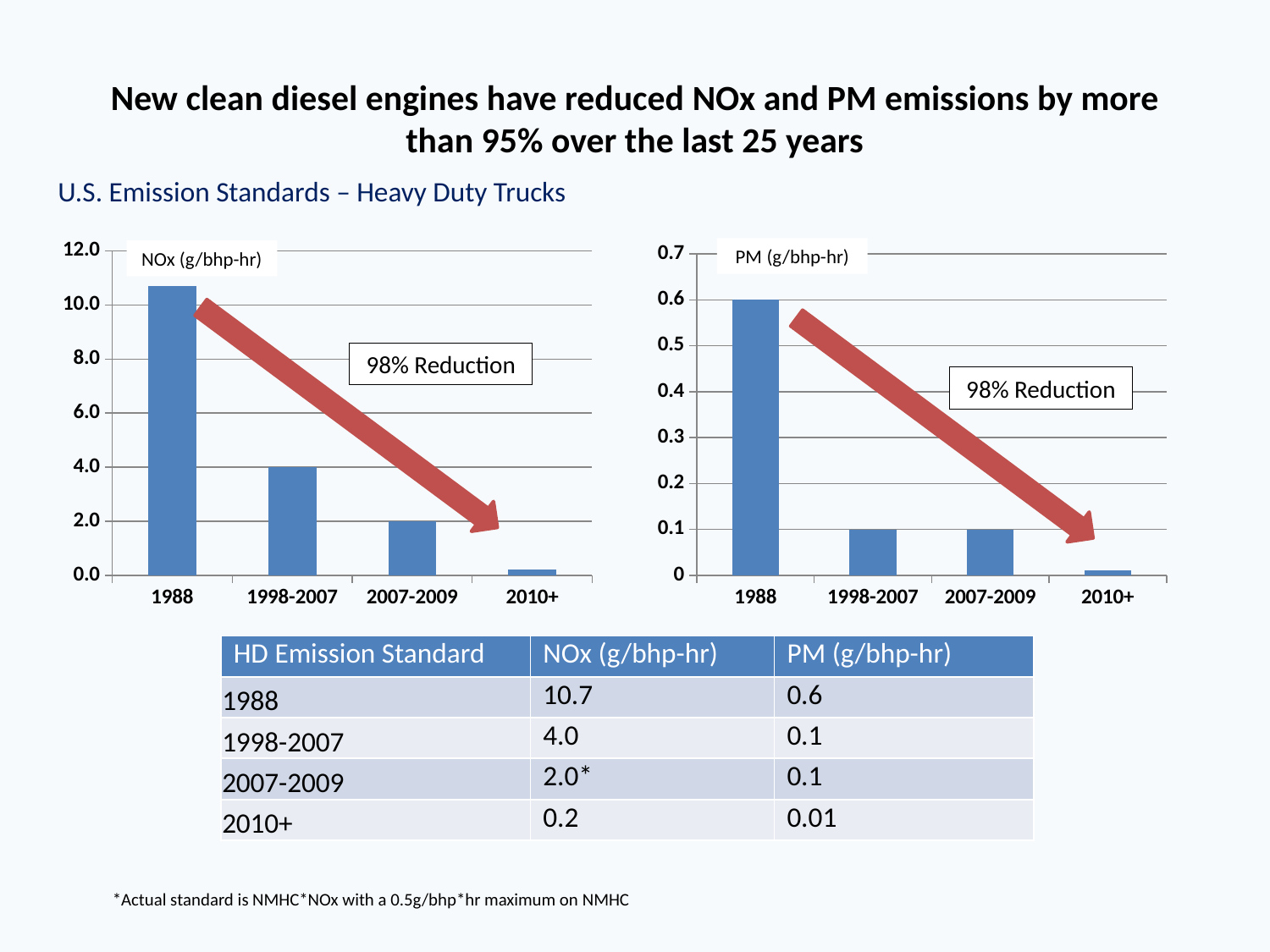
In the NOx (g/bhp-hr) chart, what is the value for 1998-2007? 4.0 In the PM (g/bhp-hr) chart, which is larger, the value for 1988 or the value for 1998-2007? 1988 How many categories are shown on the x axis of the PM (g/bhp-hr) chart? 4 In the NOx (g/bhp-hr) chart, which category has the highest value? 1988 In the NOx (g/bhp-hr) chart, is the value for 2007-2009 greater or less than 4.0? less What percentage reduction is labelled on the PM (g/bhp-hr) chart? 98% Reduction What kind of chart is the NOx (g/bhp-hr) chart? bar chart In the PM (g/bhp-hr) chart, which category has the lowest value? 2010+ In the PM (g/bhp-hr) chart, what is the value for 2010+? 0.01 In the NOx (g/bhp-hr) chart, what is the difference between the 1988 value and the 1998-2007 value? 6.7 In the NOx (g/bhp-hr) chart, do the values rise or fall from 1988 to 2010+? fall In the NOx (g/bhp-hr) chart, what is the value for 1988? 10.7